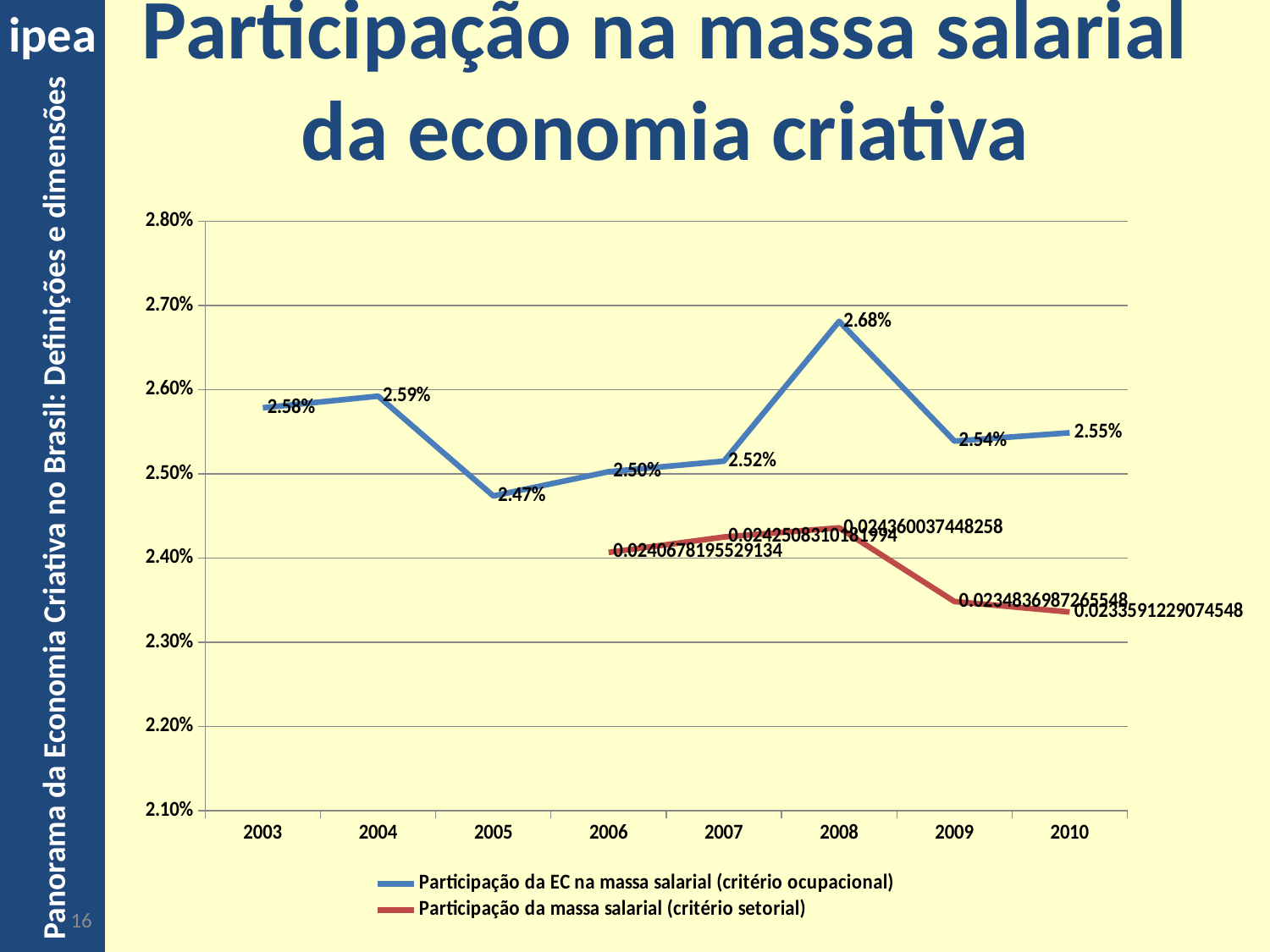
What is the value of the blue series (critério ocupacional) in 2008? 2.68% Is the value of the red series (critério setorial) in 2009 greater or less than 2.40%? less How many series does the legend list? 2 Which year has the larger value for the blue series, 2008 or 2009? 2008 What is the data label for the red series (critério setorial) in 2006? 0.0240678195529134 In which year does the blue series (critério ocupacional) reach its lowest value? 2005 What kind of chart is shown on the slide? Line chart What is the value of the blue series (critério ocupacional) in 2010? 2.55% What is the difference between the blue series values in 2008 and 2005? 0.21% How many years are shown on the x axis? 8 What is the value of the blue series (critério ocupacional) in 2005? 2.47% In which year does the blue series (critério ocupacional) reach its highest value? 2008